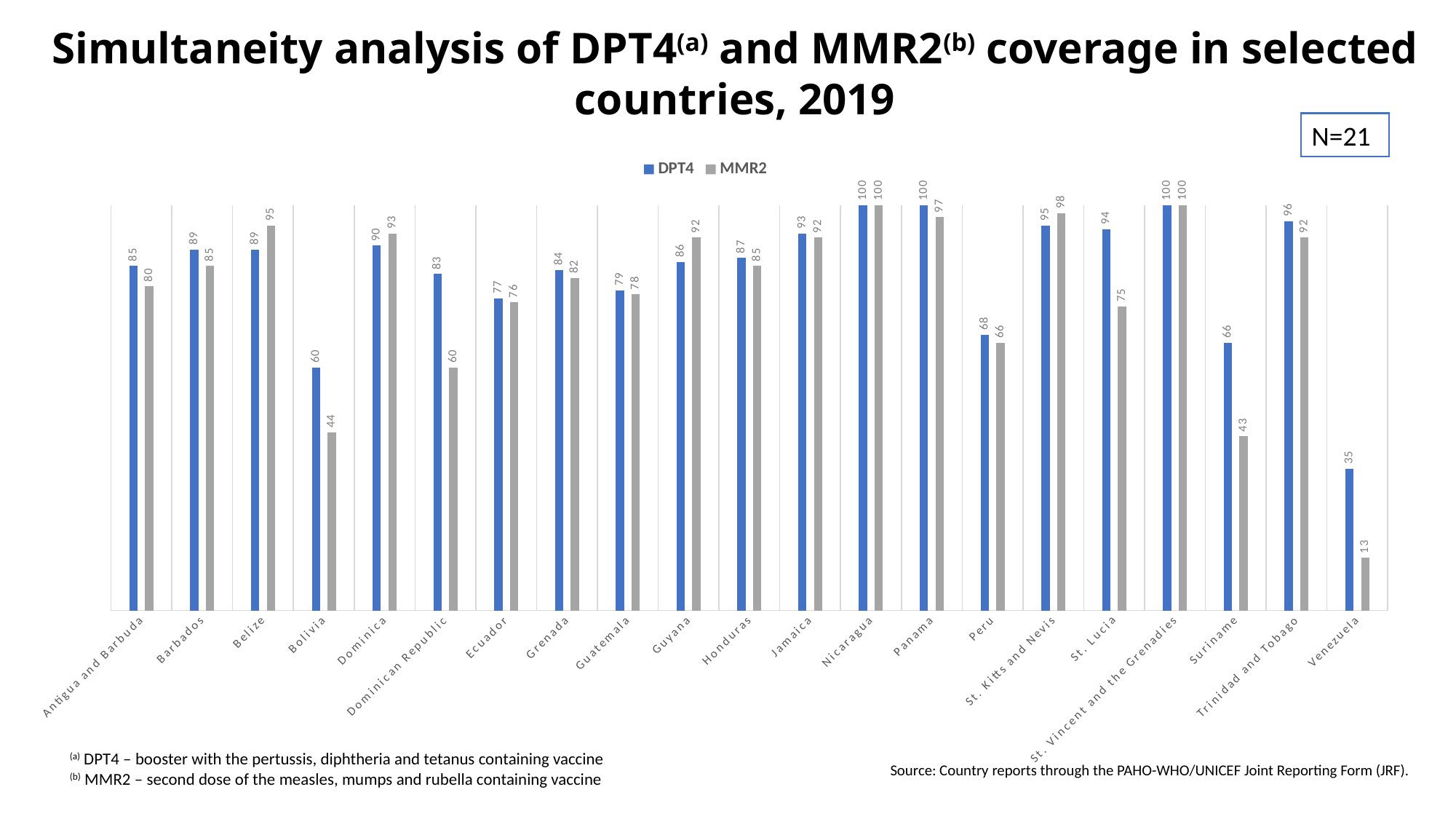
What is the difference between the DPT4 and MMR2 values for Venezuela? 22 Which is larger for Belize, the DPT4 value or the MMR2 value? MMR2 What is the MMR2 coverage value for St. Lucia? 75 Which country has the lowest MMR2 coverage? Venezuela What is the MMR2 coverage value for Suriname? 43 What is the DPT4 coverage value for Trinidad and Tobago? 96 How many countries are shown on the x axis of the chart? 21 What is the DPT4 coverage value for Bolivia? 60 What kind of chart is shown on the slide? Bar chart How many series does the legend list? 2 What is the difference between the DPT4 and MMR2 values for the Dominican Republic? 23 Which country has the lowest DPT4 coverage? Venezuela